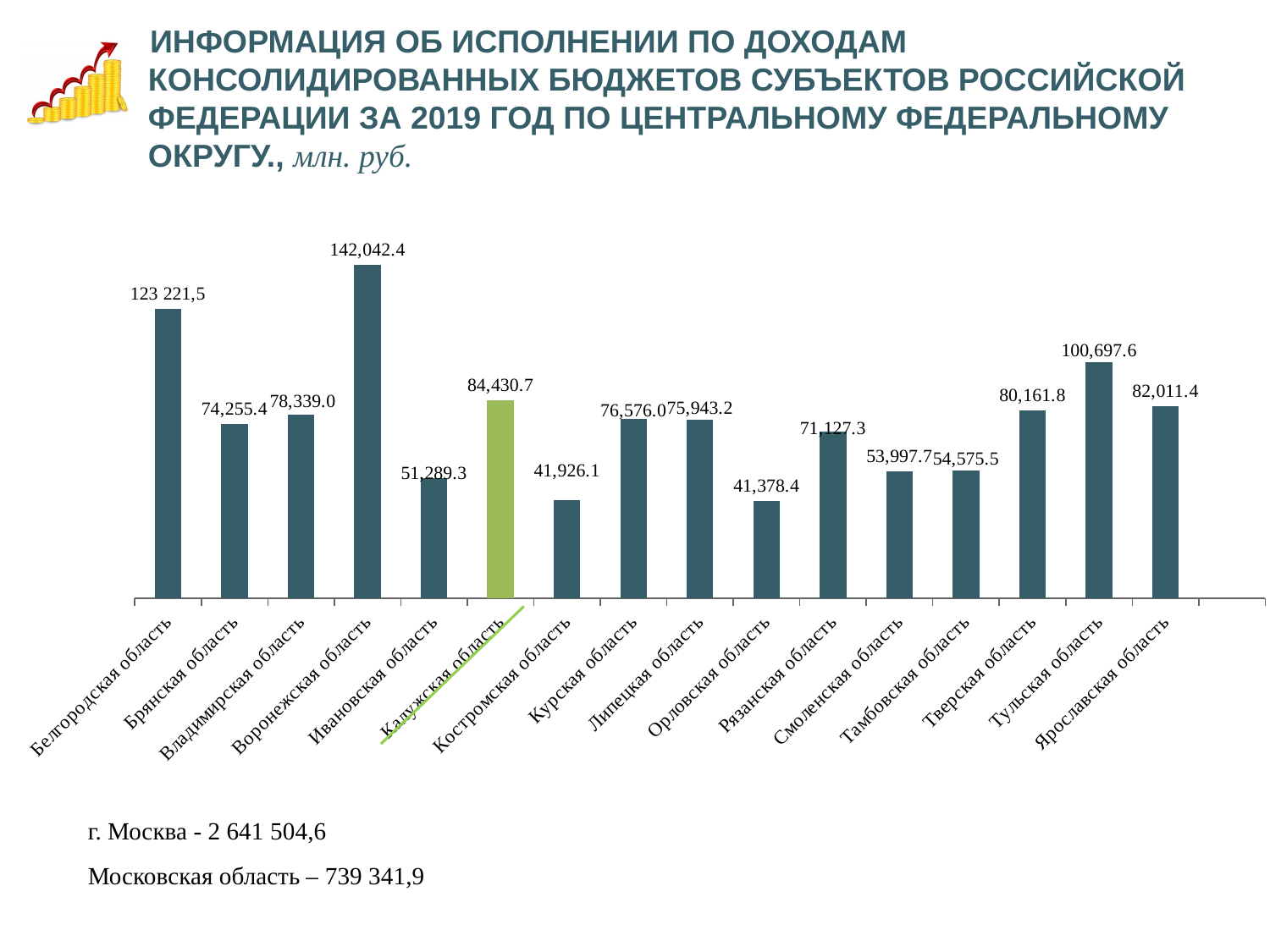
What is the value for Тульская область? 100,697.6 Which region has the highest value? Воронежская область Which is larger, the value for Смоленская область or the value for Рязанская область? Рязанская область What is the value for Костромская область? 41,926.1 What is the difference between the values for Тульская область and Тверская область? 20,535.8 How many regions are shown on the chart? 16 Which region has the lowest value? Орловская область Which region's bar is highlighted in green? Калужская область What is the difference between the values for Калужская область and Ивановская область? 33,141.4 What is the value for Калужская область? 84,430.7 Which is larger, the value for Белгородская область or the value for Тульская область? Белгородская область What kind of chart is shown on the slide? Bar chart